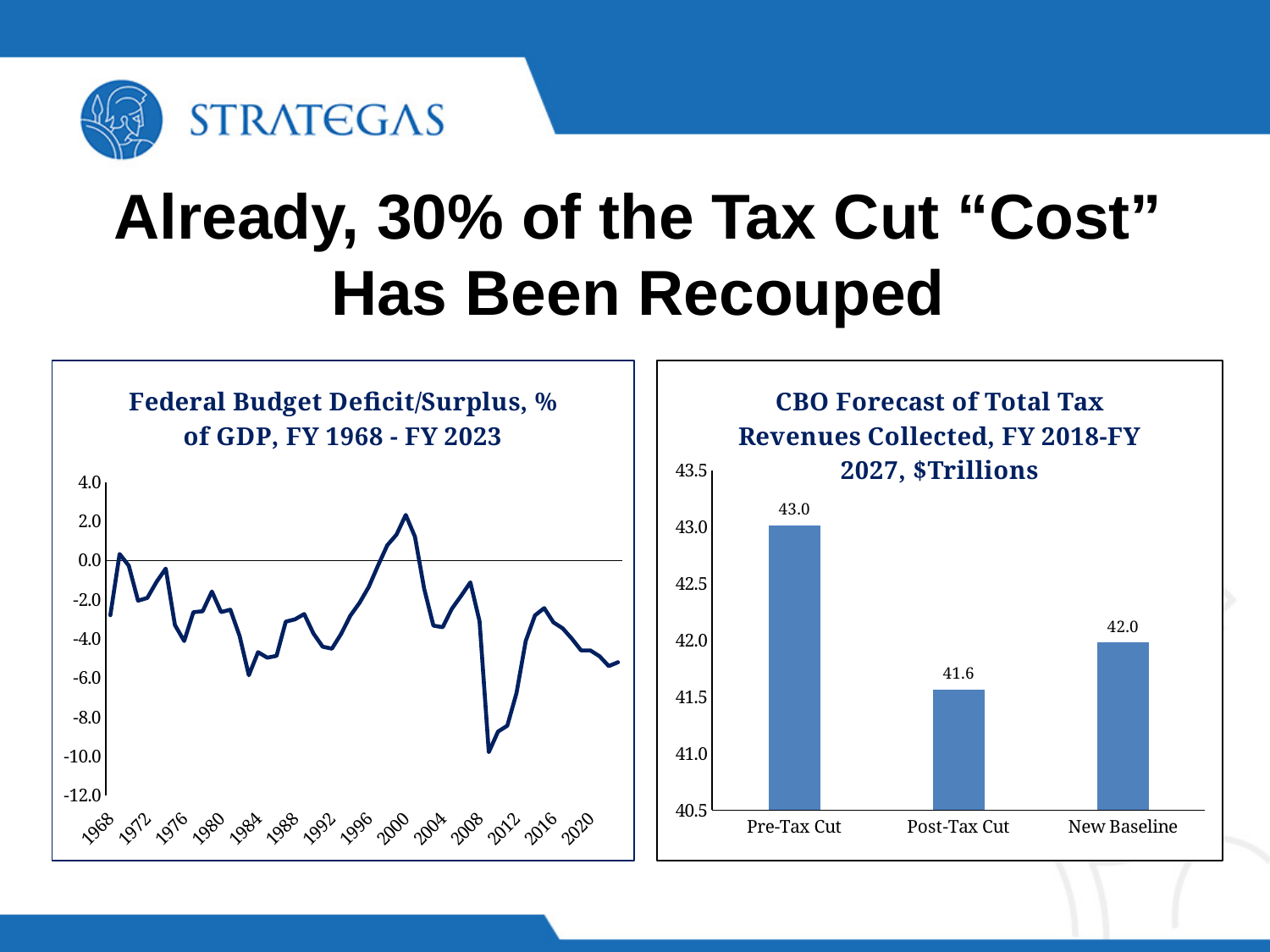
In the CBO Forecast of Total Tax Revenues chart, which category has the highest value? Pre-Tax Cut In the CBO Forecast of Total Tax Revenues chart, which is larger, New Baseline or Post-Tax Cut? New Baseline In the CBO Forecast of Total Tax Revenues chart, what is the value for New Baseline? 42.0 In the CBO Forecast of Total Tax Revenues chart, which category has the lowest value? Post-Tax Cut In the CBO Forecast of Total Tax Revenues chart, what is the difference between the New Baseline and Post-Tax Cut values? 0.4 What kind of chart is the CBO Forecast of Total Tax Revenues chart on the right? Bar chart In the CBO Forecast of Total Tax Revenues chart, what is the value for Pre-Tax Cut? 43.0 In the CBO Forecast of Total Tax Revenues chart, what is the value for Post-Tax Cut? 41.6 In the CBO Forecast of Total Tax Revenues chart, what is the difference between the Pre-Tax Cut and Post-Tax Cut values? 1.4 In the Federal Budget Deficit/Surplus chart, is the value around 2009 greater or less than -8.0? less How many categories are shown in the CBO Forecast of Total Tax Revenues chart? 3 What kind of chart is the Federal Budget Deficit/Surplus chart on the left? Line chart